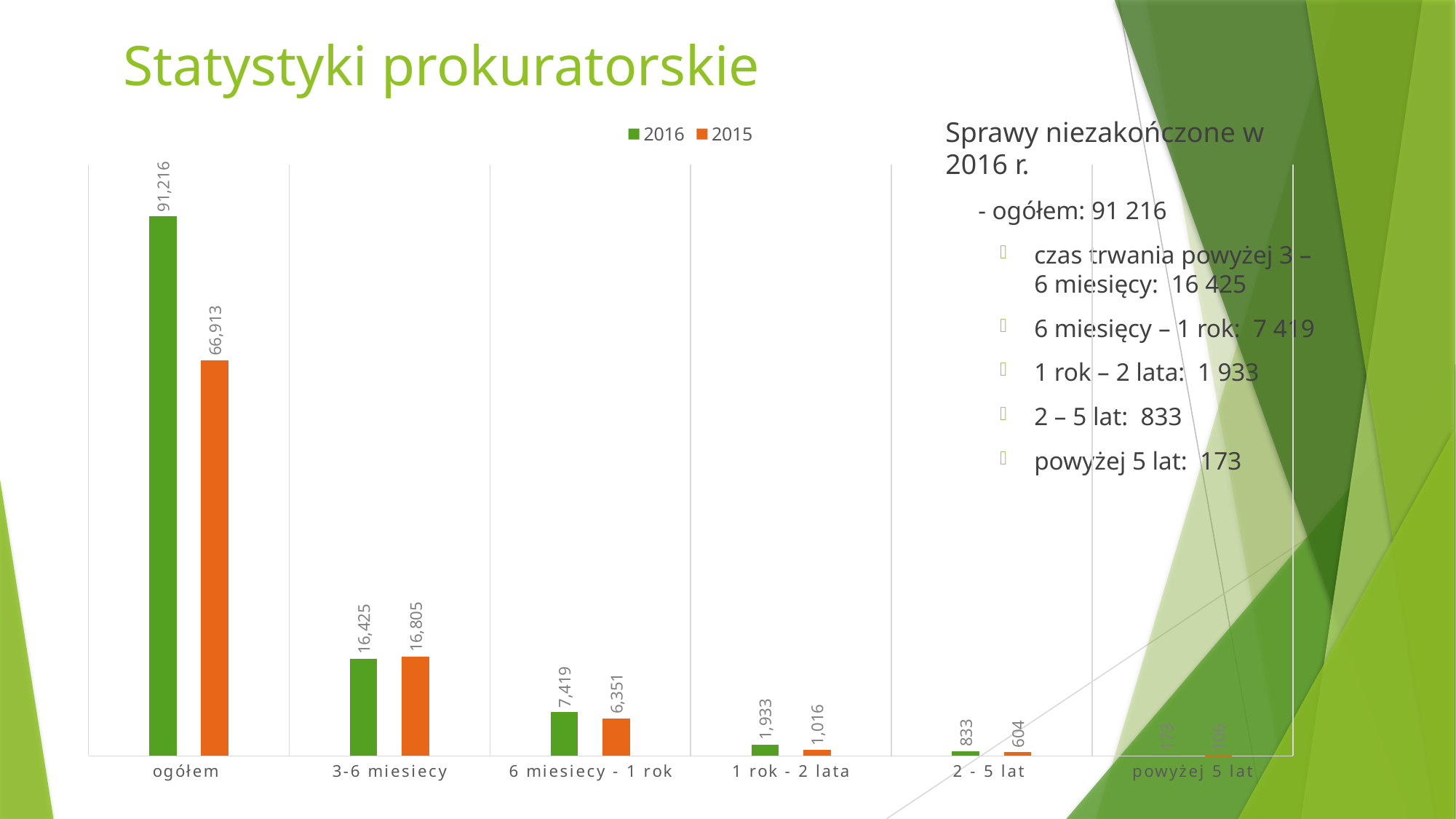
What is the value for 2015 in the 1 rok - 2 lata category? 1,016 What is the value for 2016 in the 6 miesiecy - 1 rok category? 7,419 What is the value for 2016 in the ogółem category? 91,216 Which category has the highest value for the 2016 series? ogółem What is the difference between the 2016 and 2015 values in the ogółem category? 24,303 In the 3-6 miesiecy category, which series has the larger value, 2016 or 2015? 2015 What kind of chart is shown on the slide? bar chart What is the value for 2016 in the 2 - 5 lat category? 833 What is the difference between the 2016 and 2015 values in the 6 miesiecy - 1 rok category? 1,068 What is the value for 2015 in the 3-6 miesiecy category? 16,805 How many series does the legend list? 2 What is the value for 2015 in the ogółem category? 66,913